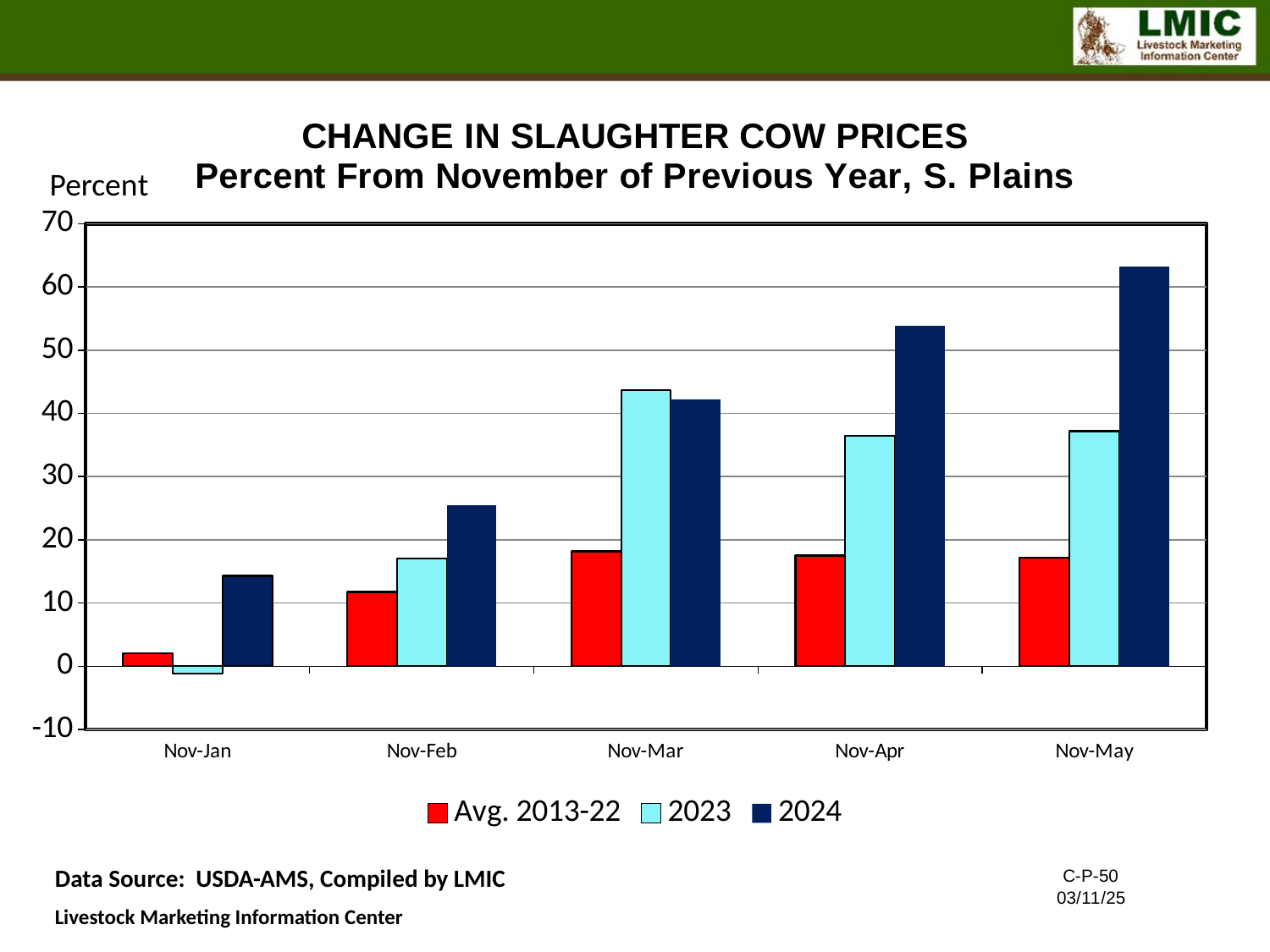
How many categories are shown on the x axis? 5 Is the 2024 value for Nov-May greater or less than 60? greater For Nov-Apr, which series has the larger value, 2023 or 2024? 2024 Which category has the lowest value for the 2023 series? Nov-Jan Which category has the highest value for the 2024 series? Nov-May What kind of chart is shown on the slide? bar chart Is the 2023 value for Nov-Jan greater or less than 0? less How many series does the legend list? 3 Do the values for the 2024 series rise or fall from Nov-Jan to Nov-May? rise What are the three series listed in the legend? Avg. 2013-22, 2023, 2024 Is the Avg. 2013-22 value for Nov-Feb greater or less than 10? greater